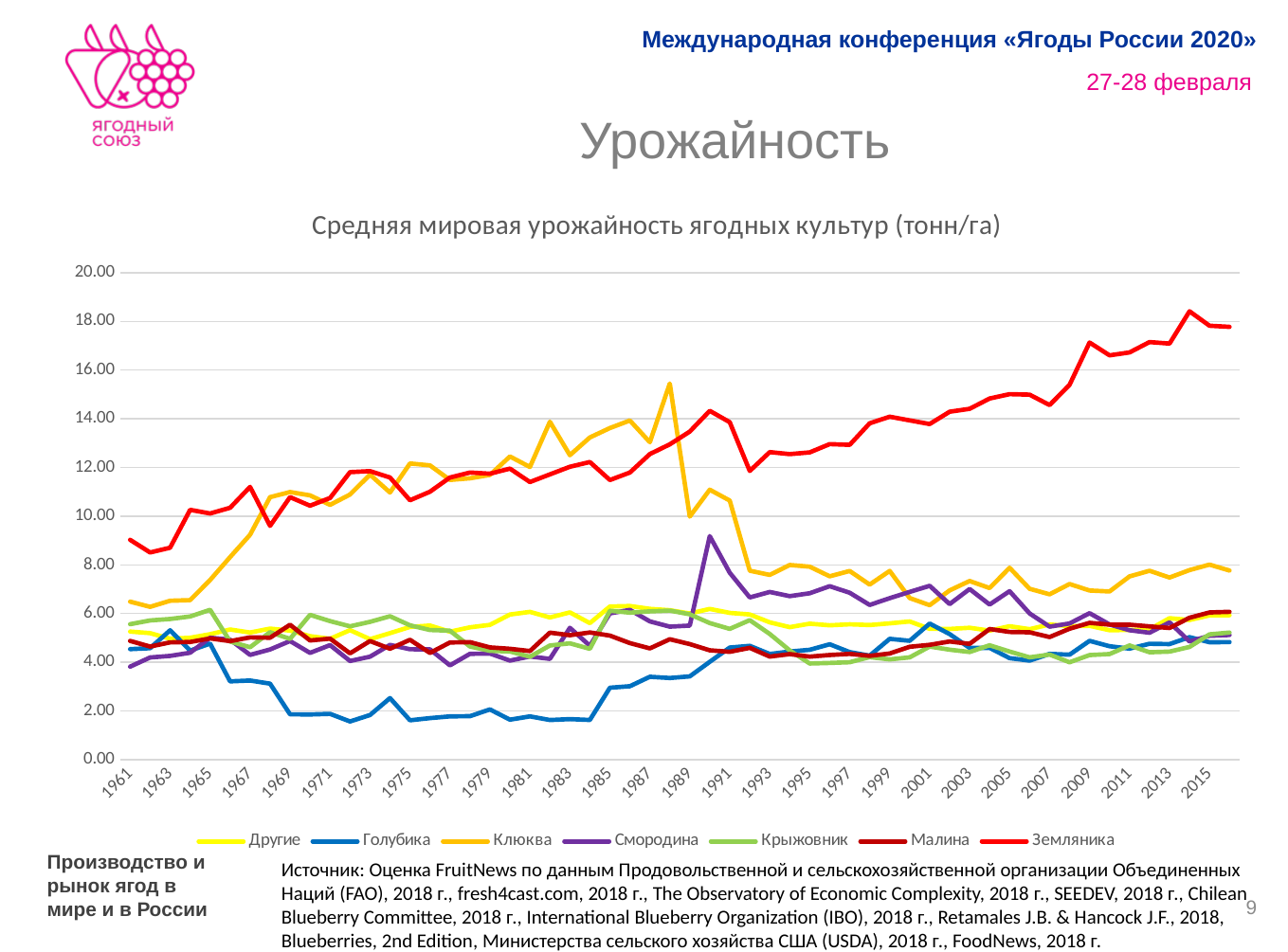
Is the value for Клюква in 2015 greater or less than 10.00? less Which series is drawn in red in the chart? Земляника Which series reaches the highest value anywhere on the chart? Земляника What is the title of the chart? Средняя мировая урожайность ягодных культур (тонн/га) Which series has the lowest value in 1975? Голубика What kind of chart is shown on the slide? line chart How many series does the legend list? 7 Does the value for Земляника generally rise or fall from 1961 to the end of the chart? rise Is the value for Голубика in 1975 greater or less than 4.00? less In 2005, which is larger, Земляника or Клюква? Земляника Is the value for Земляника in 2015 greater or less than 16.00? greater Which series has the highest value in 2015? Земляника